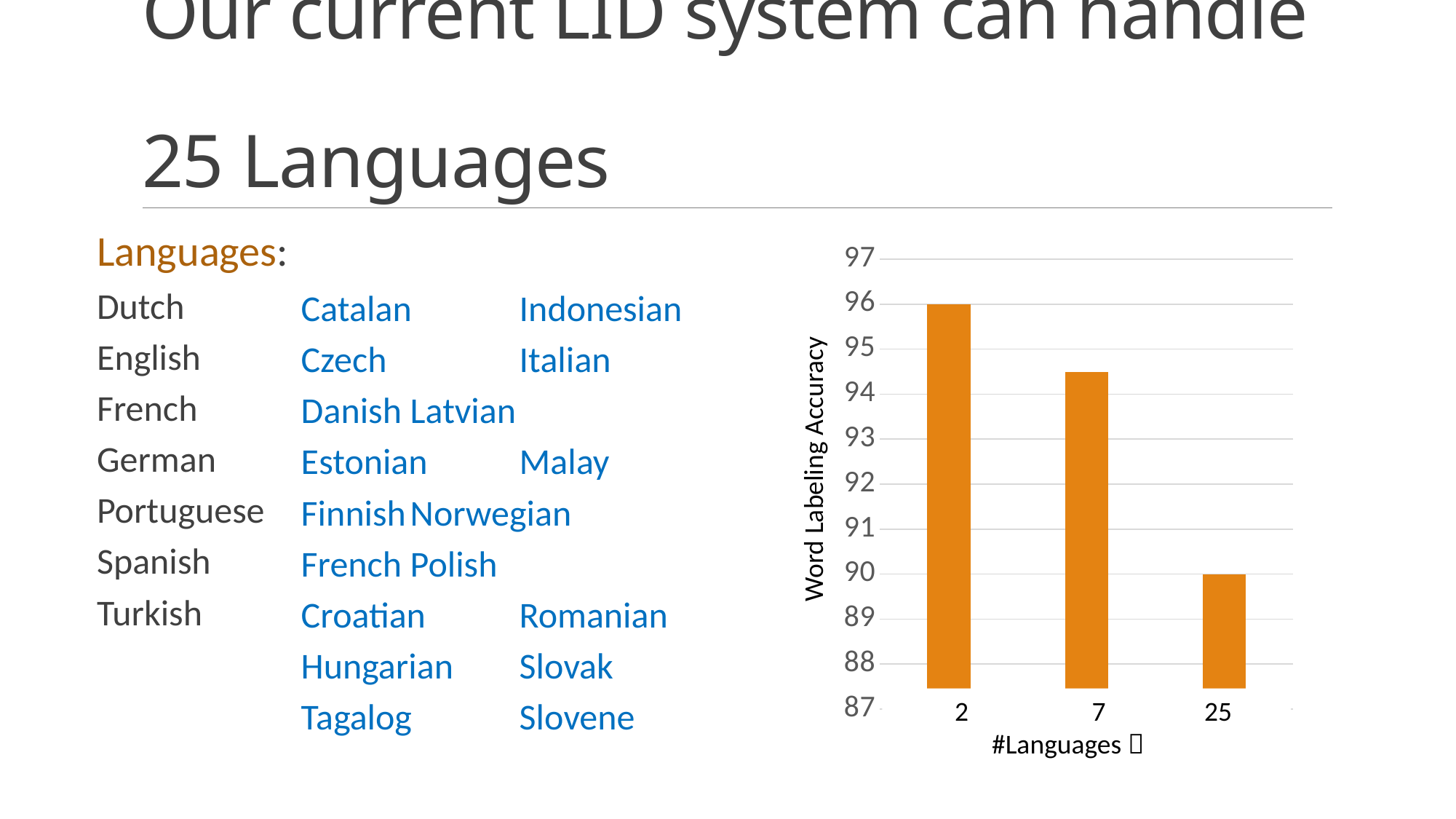
Is the Word Labeling Accuracy for 7 languages greater or less than 94? greater What is the Word Labeling Accuracy when #Languages is 25? 90 Is the Word Labeling Accuracy for 7 languages greater or less than 95? less Which #Languages value has the highest Word Labeling Accuracy? 2 Which #Languages value has the lowest Word Labeling Accuracy? 25 What kind of chart is shown on the slide? bar chart Does Word Labeling Accuracy rise or fall as #Languages increases along the x axis? fall What is the label of the y axis of the chart? Word Labeling Accuracy Which has a higher Word Labeling Accuracy, 7 languages or 25 languages? 7 languages What is the difference in Word Labeling Accuracy between 2 languages and 25 languages? 6 What is the Word Labeling Accuracy when #Languages is 2? 96 How many bars are plotted in the chart? 3